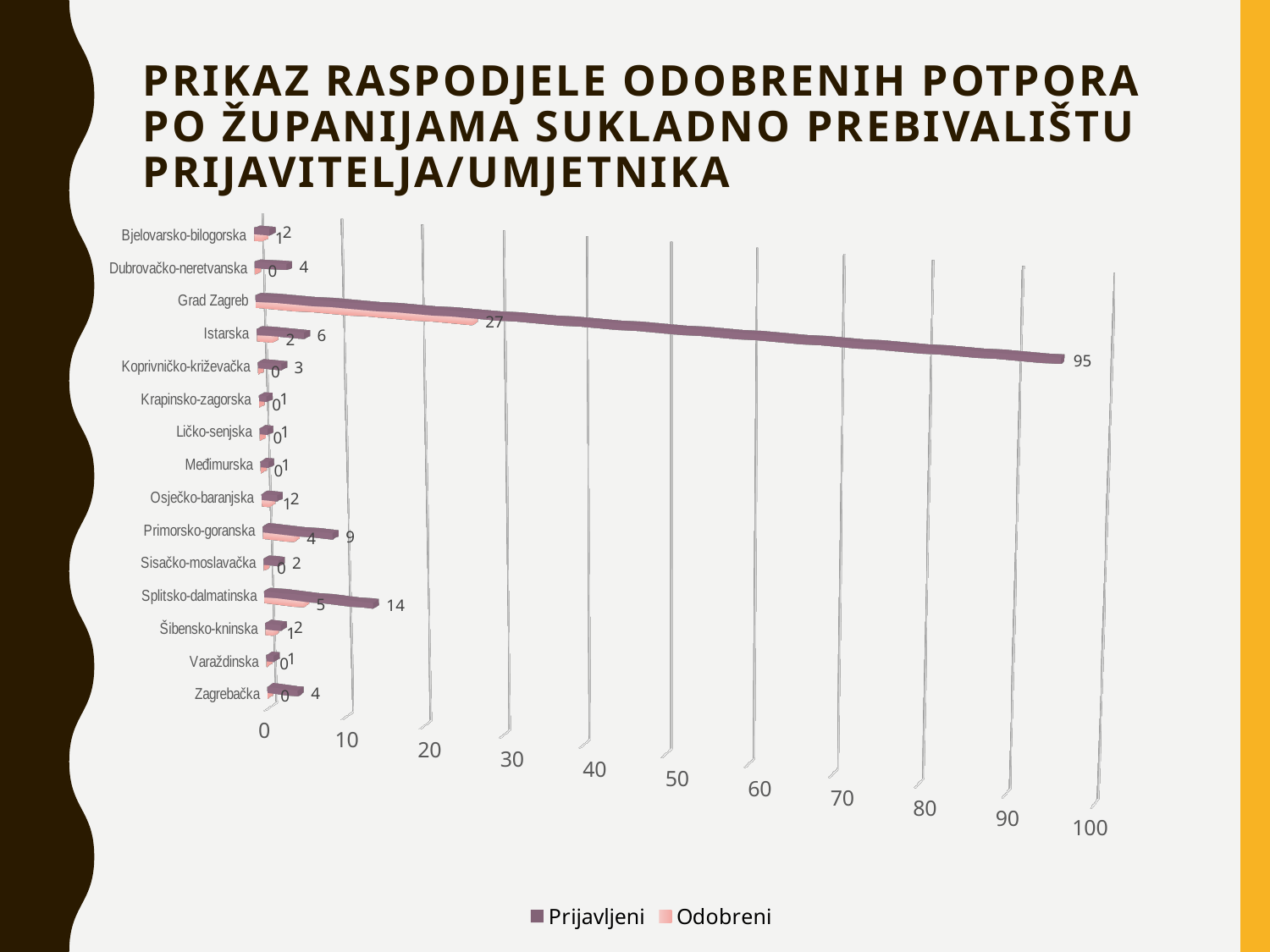
What is the Odobreni value for Primorsko-goranska? 4 Which category has the highest Prijavljeni value? Grad Zagreb What is the Prijavljeni value for Splitsko-dalmatinska? 14 What is the difference between the Prijavljeni values for Splitsko-dalmatinska and Primorsko-goranska? 5 What is the difference between the Prijavljeni and Odobreni values for Grad Zagreb? 68 What kind of chart is shown on the slide? Bar chart How many categories (counties) are shown on the chart? 15 Which is larger, the Prijavljeni value for Istarska or for Primorsko-goranska? Primorsko-goranska What is the Prijavljeni value for Grad Zagreb? 95 Is the Prijavljeni value for Grad Zagreb greater or less than 90? greater How many series does the legend list? 2 What is the Odobreni value for Grad Zagreb? 27